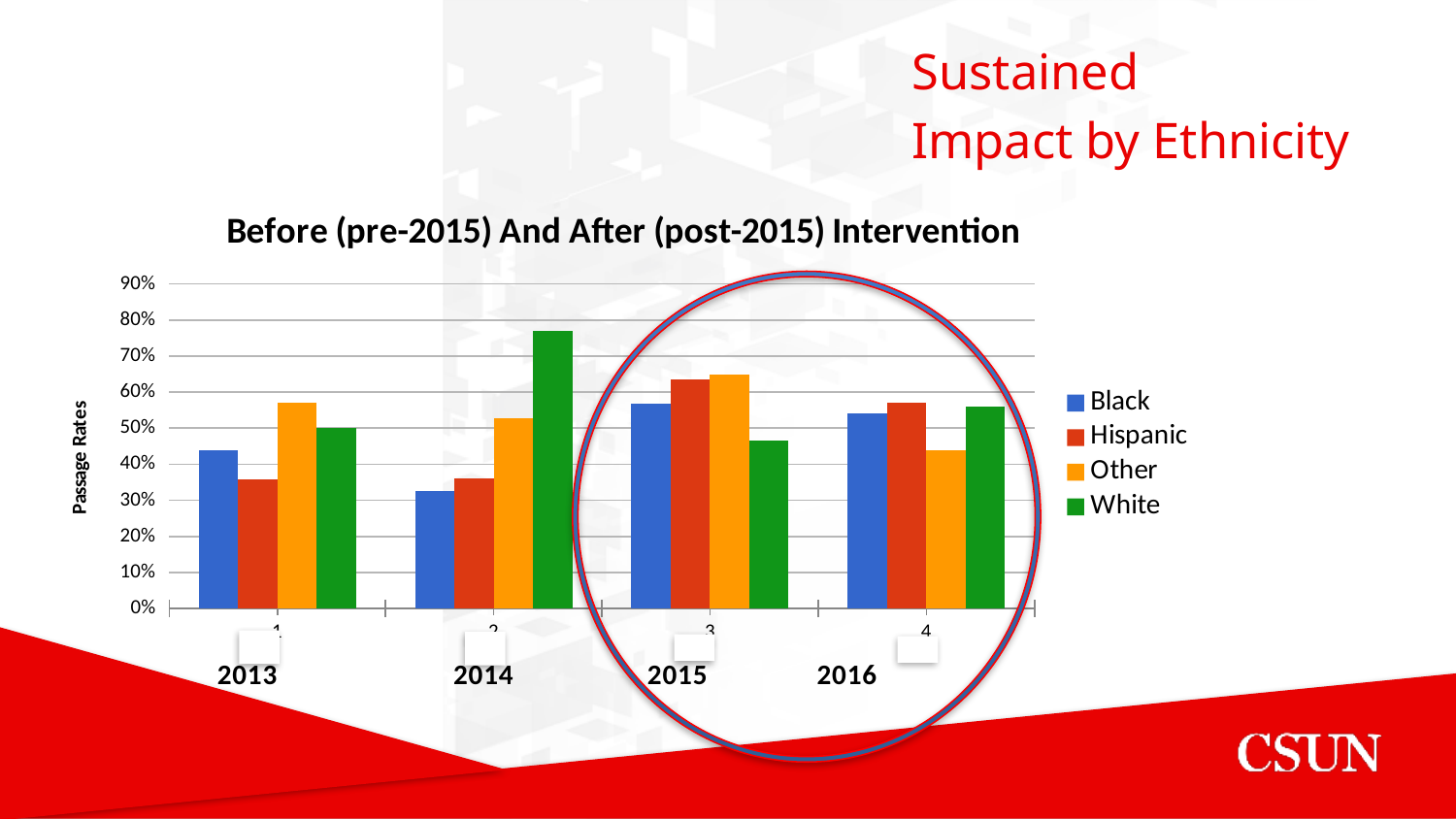
How many series does the legend list? 4 Is the value for Black in 2014 greater or less than 40%? less In 2013, which is larger: the value for Other or the value for Hispanic? Other What kind of chart is shown on the slide? bar chart Which group has the tallest bar in 2014? White What is the label on the y axis? Passage Rates Is the value for White in 2014 greater or less than 70%? greater Does the value for Black rise or fall from 2014 to 2015? rise Which group has the lowest bar in 2014? Black In 2015, which is larger: the value for Hispanic or the value for White? Hispanic Is the value for Other in 2015 greater or less than 60%? greater How many years are shown along the x axis? 4